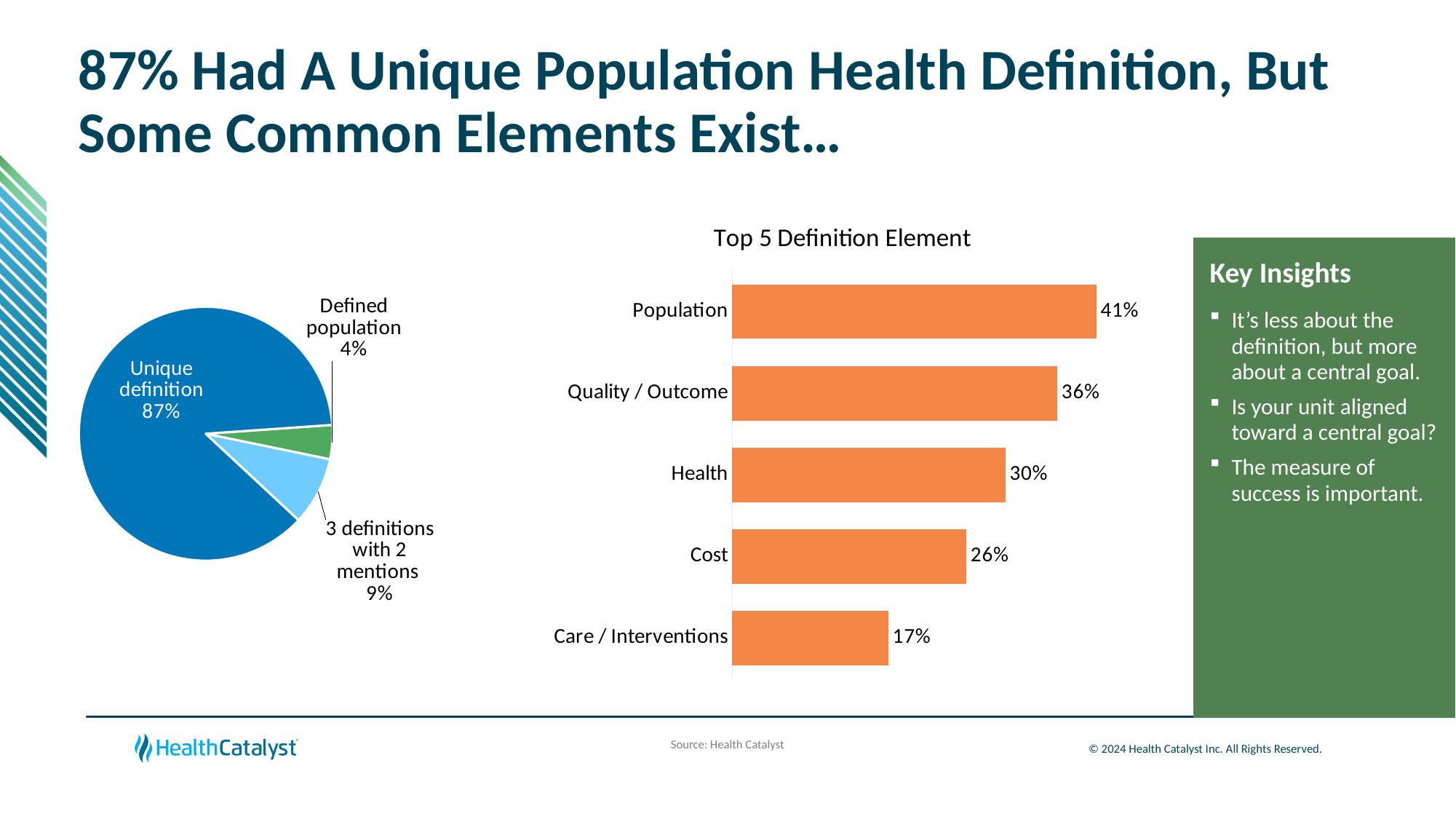
In the pie chart on the left, what share does 'Unique definition' have? 87% In the pie chart on the left, which slice is the smallest? Defined population What kind of chart is the 'Top 5 Definition Element' chart? Bar chart In the 'Top 5 Definition Element' bar chart, which category has the lowest value? Care / Interventions How many slices does the pie chart on the left have? 3 In the pie chart on the left, what share does '3 definitions with 2 mentions' have? 9% In the 'Top 5 Definition Element' bar chart, which category has the highest value? Population In the 'Top 5 Definition Element' bar chart, which is larger, the value for Health or the value for Cost? Health How many categories are shown in the 'Top 5 Definition Element' bar chart? 5 In the 'Top 5 Definition Element' bar chart, what is the difference between the values for Quality / Outcome and Health? 6% In the 'Top 5 Definition Element' bar chart, what is the value for Population? 41% In the 'Top 5 Definition Element' bar chart, what is the value for Cost? 26%